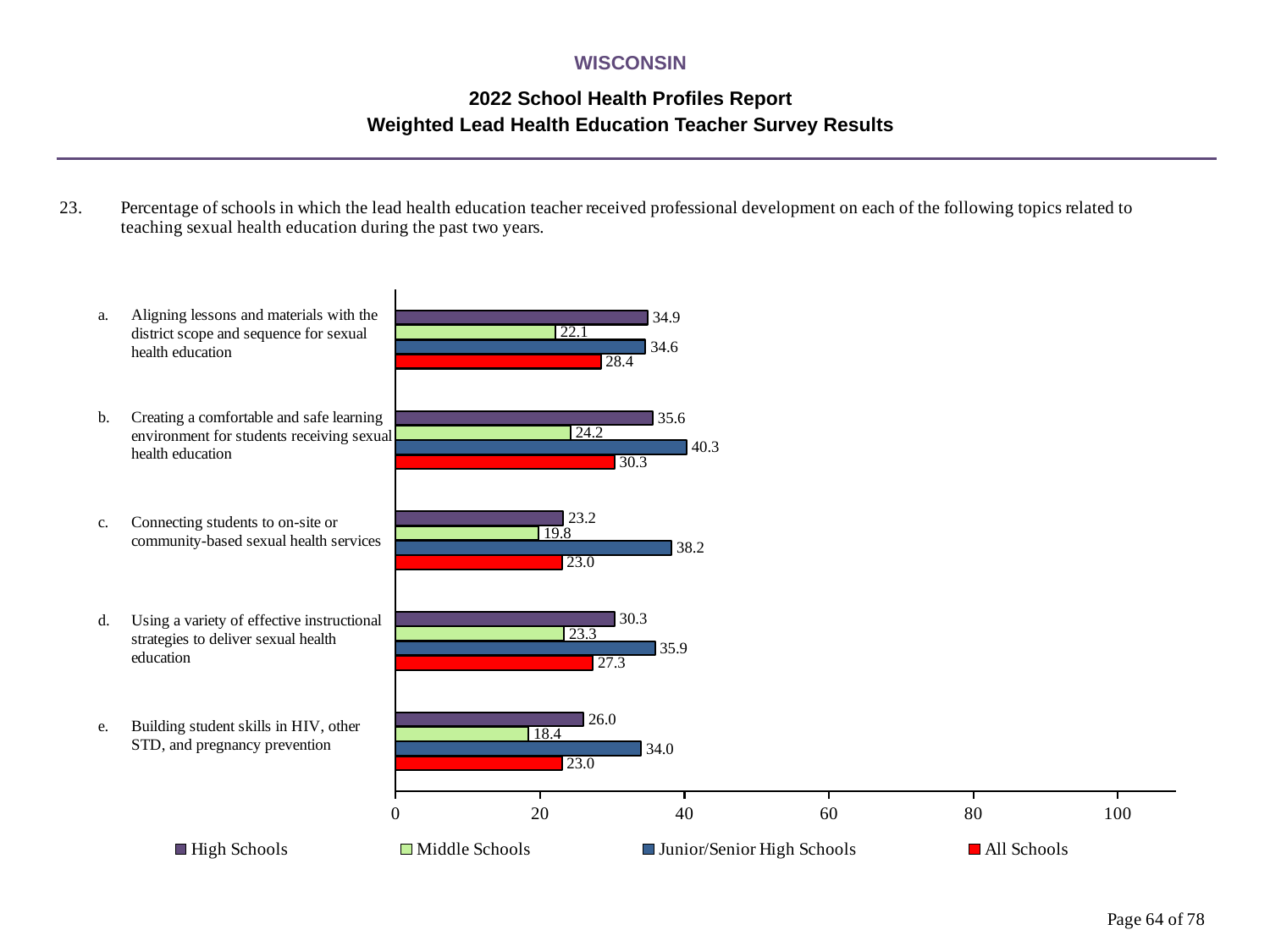
How many series does the legend list? 4 What is the value for Junior/Senior High Schools for topic b, creating a comfortable and safe learning environment for students receiving sexual health education? 40.3 What is the difference between the Junior/Senior High Schools value and the Middle Schools value for topic c, connecting students to on-site or community-based sexual health services? 18.4 Which topic has the highest value for Junior/Senior High Schools? b. Creating a comfortable and safe learning environment for students receiving sexual health education What is the value for High Schools for topic a, aligning lessons and materials with the district scope and sequence for sexual health education? 34.9 What is the All Schools value for topic d, using a variety of effective instructional strategies to deliver sexual health education? 27.3 For topic a, which is larger: the High Schools value or the Junior/Senior High Schools value? High Schools Is the Junior/Senior High Schools value for topic b greater or less than 40? greater How many topics (categories) are plotted in the chart? 5 What is the value for Middle Schools for topic e, building student skills in HIV, other STD, and pregnancy prevention? 18.4 What kind of chart is shown on the slide? Bar chart Which topic has the lowest value for Middle Schools? e. Building student skills in HIV, other STD, and pregnancy prevention